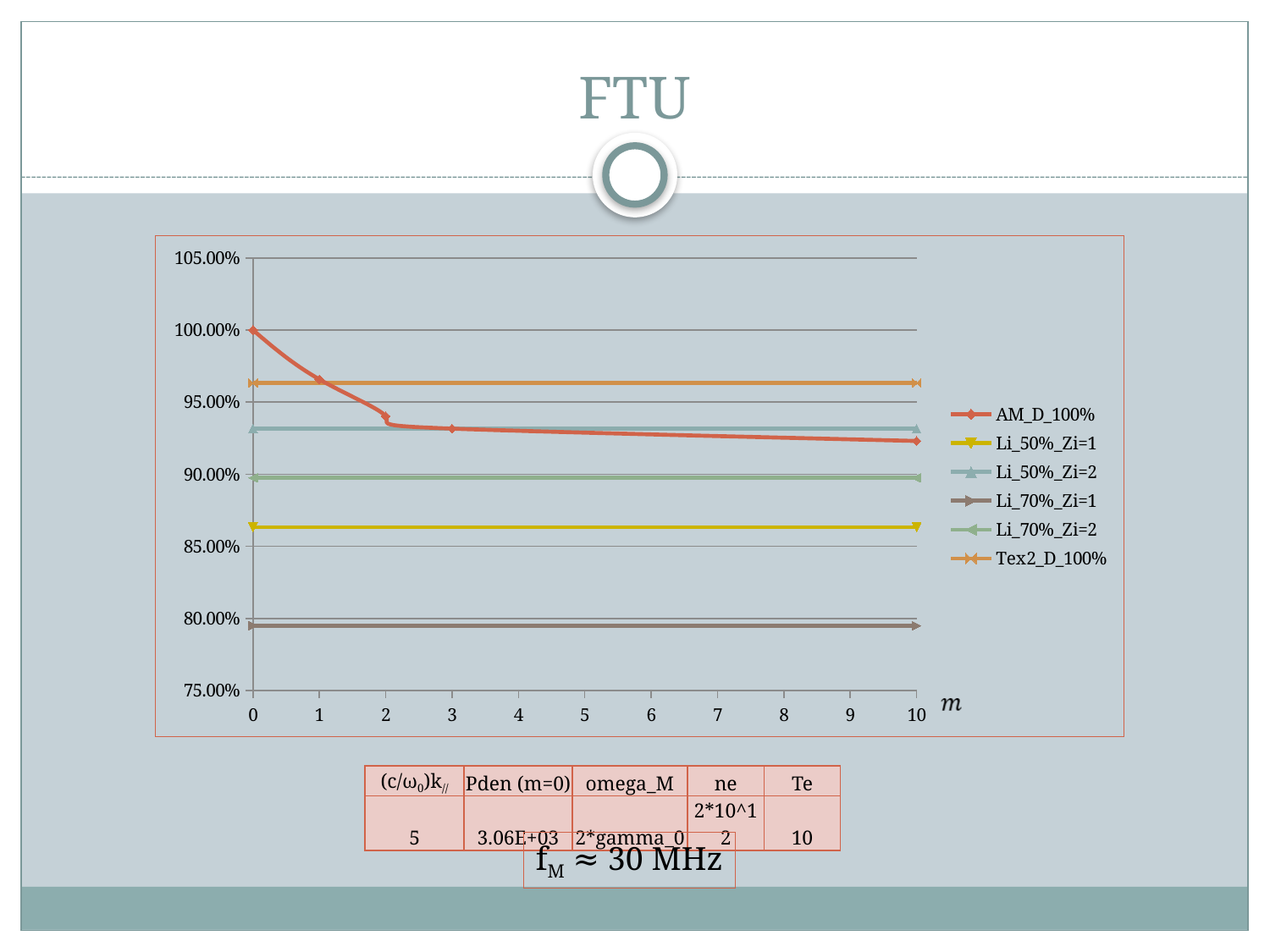
Which series has the highest value at m = 0? AM_D_100% Is the value for Tex2_D_100% greater or less than 95.00%? greater How many series does the chart legend list? 6 Which series has the highest value at m = 10? Tex2_D_100% Is the value for Li_50%_Zi=1 greater or less than 90.00%? less Does the AM_D_100% series rise or fall as m increases? fall Which series has the lowest values across the chart? Li_70%_Zi=1 Is the value for Li_70%_Zi=1 greater or less than 85.00%? less What is the label on the x axis of the chart? m What is the value of AM_D_100% at m = 0? 100.00% What kind of chart is shown on the slide? line chart Which series has larger values, Li_50%_Zi=2 or Li_70%_Zi=2? Li_50%_Zi=2